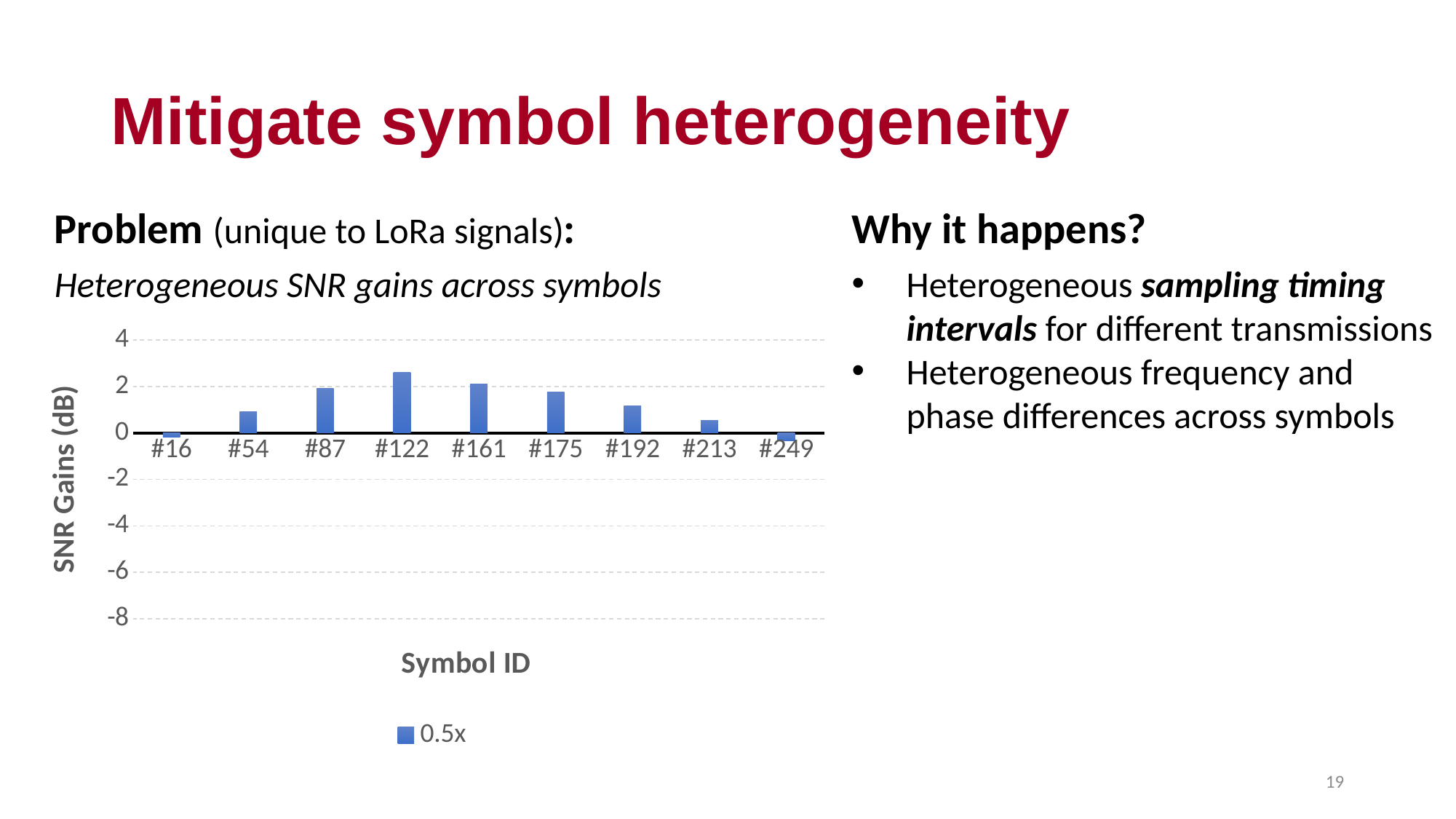
What kind of chart is shown on the slide? bar chart Which symbol ID has the highest SNR gain in the chart? #122 How many series does the chart legend list? 1 How many symbol IDs are plotted on the x axis of the chart? 9 Do the SNR gains rise or fall along the x axis from symbol #122 to symbol #249? fall Is the SNR gain for symbol #54 greater or less than 2 dB? less Is the SNR gain for symbol #16 greater or less than 2 dB? less What is the label of the y axis of the chart? SNR Gains (dB) Is the SNR gain for symbol #213 greater or less than 2 dB? less Which has the larger SNR gain, symbol #87 or symbol #213? #87 Which has the larger SNR gain, symbol #122 or symbol #54? #122